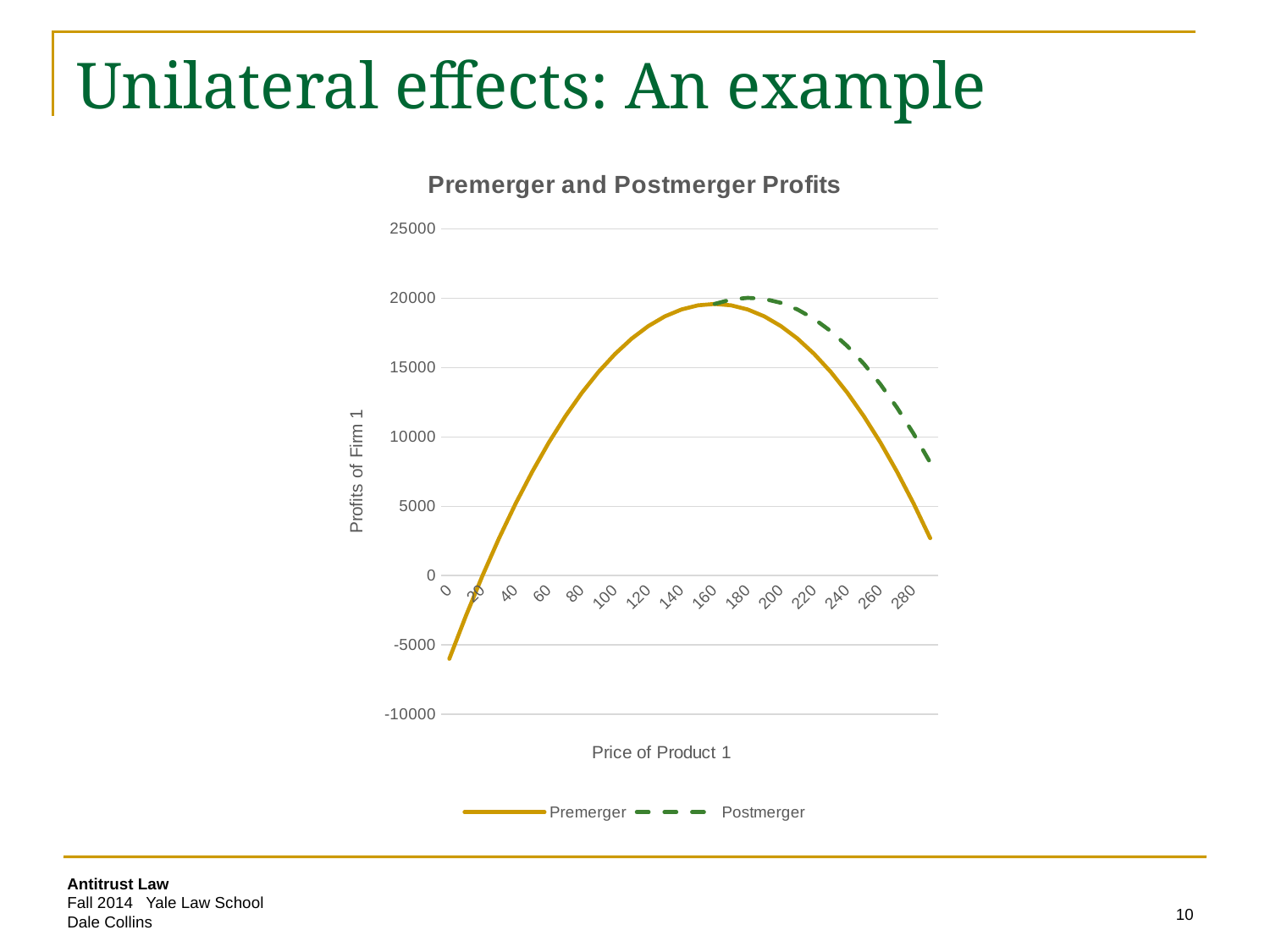
At a price of 240, which series shows the higher profit, Premerger or Postmerger? Postmerger Is the Premerger profit at a price of 0 greater or less than 0? less What are the two series named in the legend? Premerger and Postmerger Is the Premerger profit at a price of 160 greater or less than 15000? greater What kind of chart is shown on the slide? line chart How many series does the legend list? 2 Is the Postmerger profit at a price of 280 greater or less than 5000? greater Does the Premerger profit rise or fall as the price increases from 0 to 160? rise What is the title of the chart? Premerger and Postmerger Profits Does the Postmerger profit rise or fall as the price increases from 200 to 280? fall